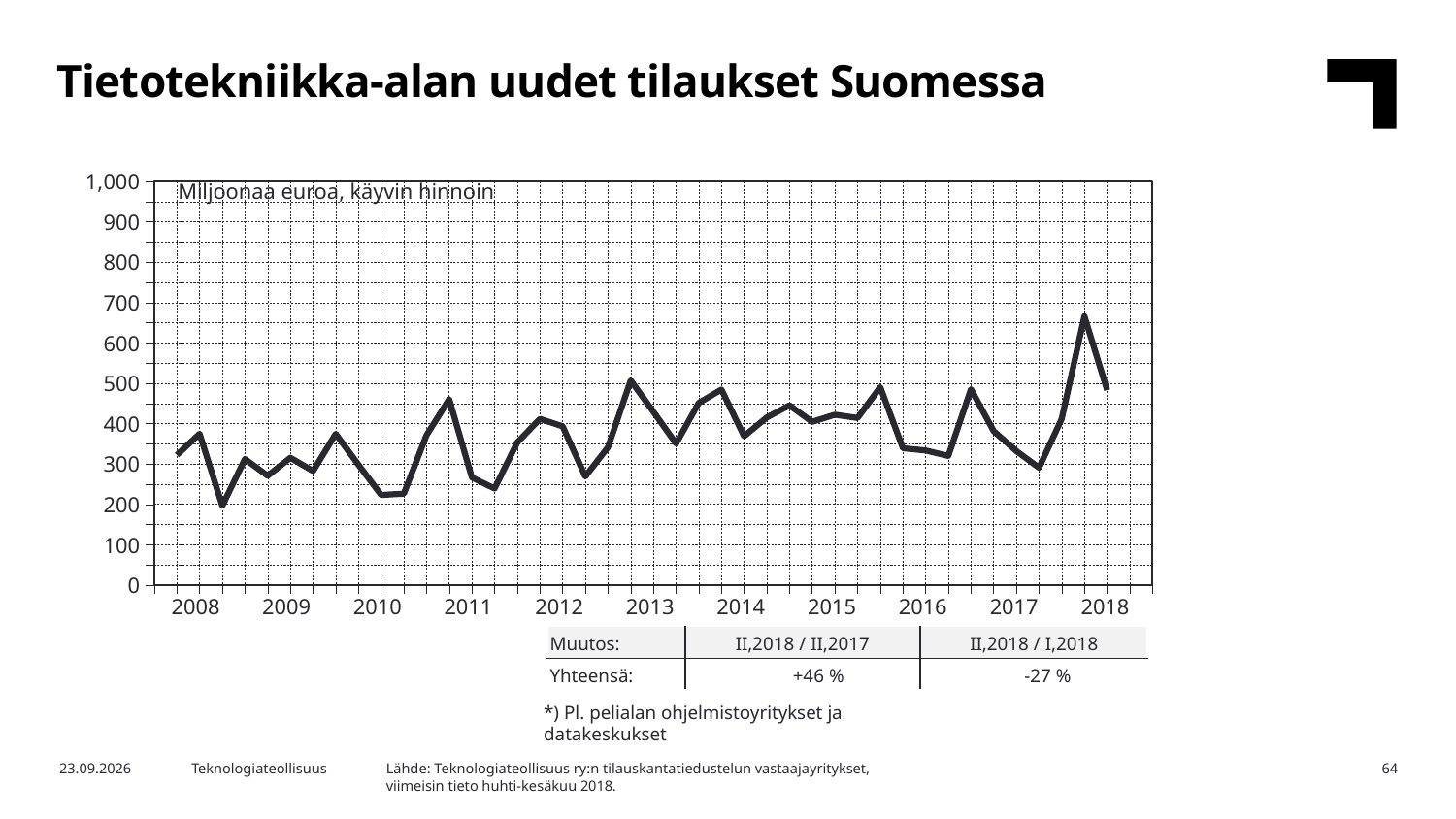
According to the table below the chart, what is the change for II,2018 / II,2017? +46 % Near which year label does the line reach its lowest point? 2008 Near which year label does the line reach its highest peak? 2018 What unit is stated inside the chart area? Miljoonaa euroa, käyvin hinnoin Is the lowest point of the line, in 2008, greater or less than 300? less Is the highest peak of the line greater or less than 600? greater What is the title of the slide's chart? Tietotekniikka-alan uudet tilaukset Suomessa How many year labels are shown on the x axis? 11 Does the line rise or fall between its peak near 2018 and the final point? fall What kind of chart is shown on the slide? line chart Is the last plotted value, in 2018, greater or less than 400? greater What is the highest value shown on the y axis? 1,000